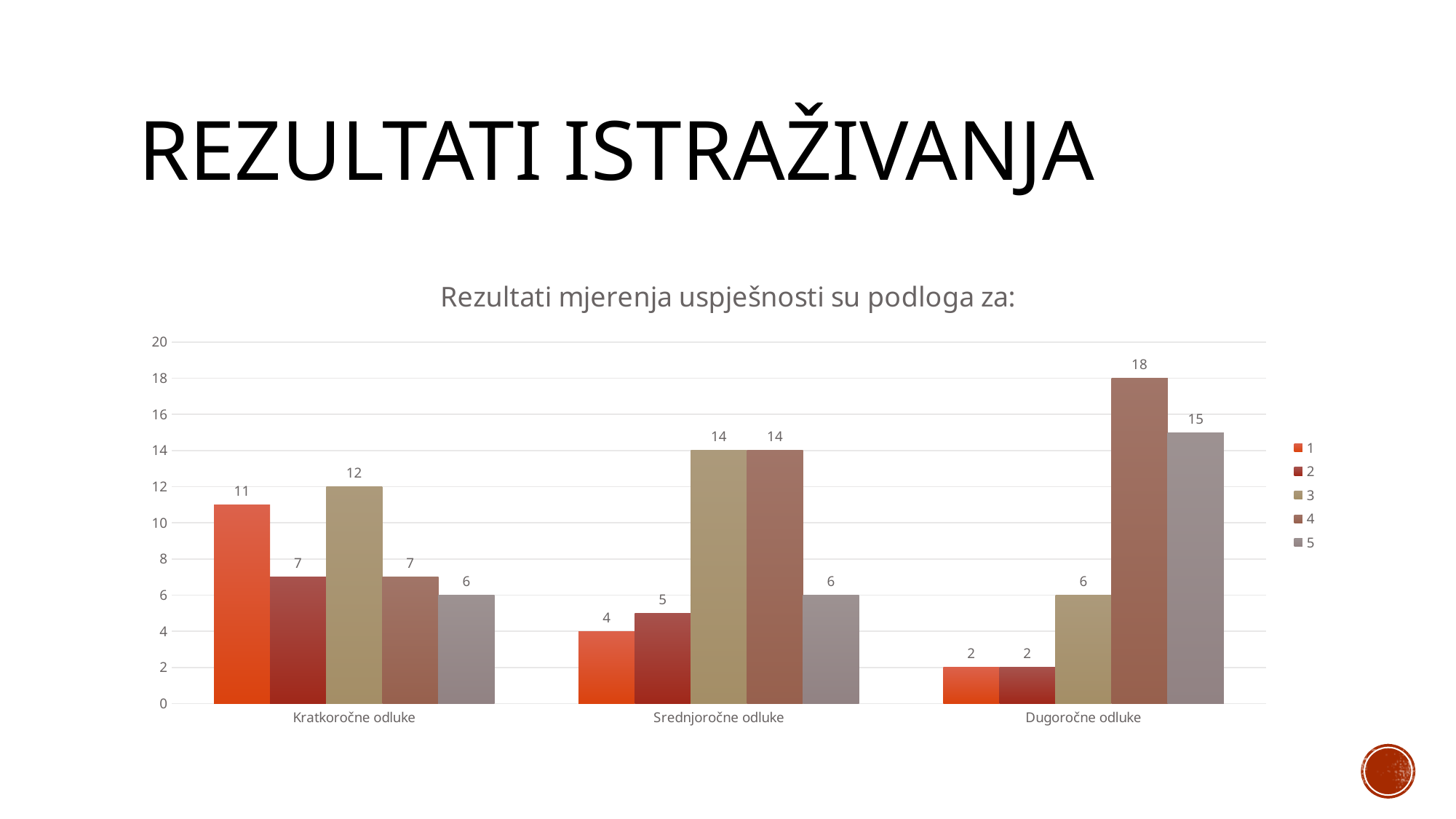
What is the difference between series 4 and series 5 in the Dugoročne odluke category? 3 How many series does the legend list? 5 Do the values for series 4 rise or fall across the categories from left to right? Rise Which series has the highest value in the Dugoročne odluke category? 4 What kind of chart is shown on the slide? Bar chart What is the title of the chart? Rezultati mjerenja uspješnosti su podloga za: How many categories are shown on the x axis? 3 What is the value for series 1 in the Kratkoročne odluke category? 11 Which series has the lowest value in the Srednjoročne odluke category? 1 Which is larger: series 3 in Kratkoročne odluke or series 3 in Dugoročne odluke? Kratkoročne odluke What is the value for series 4 in the Dugoročne odluke category? 18 What is the value for series 3 in the Srednjoročne odluke category? 14